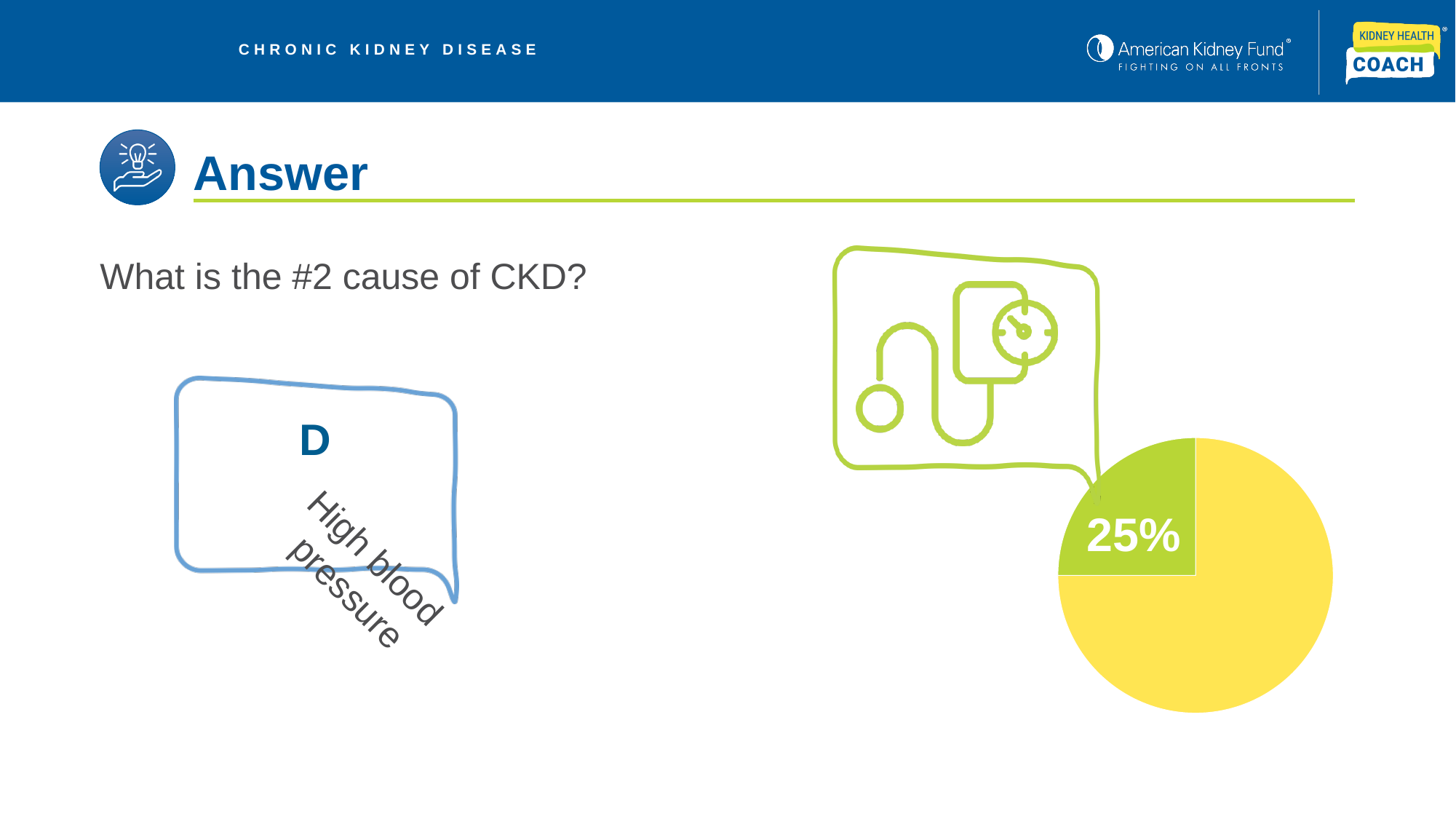
What value is printed on the green slice of the pie chart? 25% What kind of chart is shown on the slide? pie chart Which slice of the pie chart is the largest? the yellow slice What share of the pie chart does the green slice represent? 25% Which slice of the pie chart is larger, the green slice or the yellow slice? yellow Does the pie chart show a legend? No Which slice of the pie chart is the smallest? the green slice What colour is the slice of the pie chart that carries the 25% label? green Is the green slice of the pie chart greater or less than half of the pie? less How many slices does the pie chart have? 2